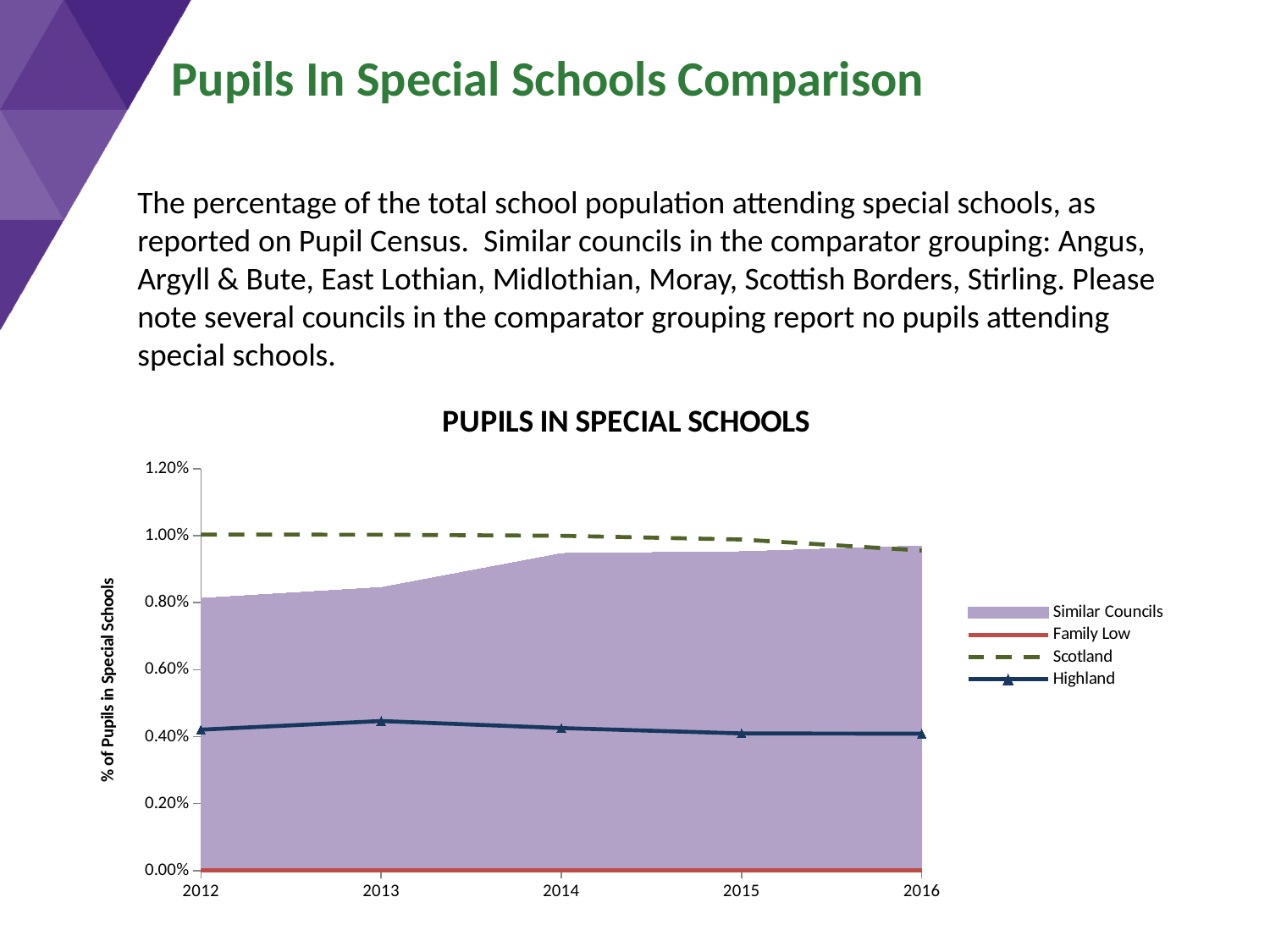
What is the value for Family Low in 2014 on the PUPILS IN SPECIAL SCHOOLS chart? 0.00% How many years are shown on the x axis of the PUPILS IN SPECIAL SCHOOLS chart? 5 Do the values for Scotland rise or fall from 2012 to 2016? fall Which series is drawn as a dashed line on the PUPILS IN SPECIAL SCHOOLS chart? Scotland What kind of chart is the PUPILS IN SPECIAL SCHOOLS chart? area and line chart Is the value for Similar Councils in 2012 greater or less than 1.00%? less In 2014, which is larger: the value for Scotland or the value for Highland? Scotland How many series does the legend of the PUPILS IN SPECIAL SCHOOLS chart list? 4 Do the values for Similar Councils rise or fall from 2012 to 2016? rise Is the value for Similar Councils in 2014 greater or less than 0.80%? greater Is the value for Highland in 2016 greater or less than 0.60%? less